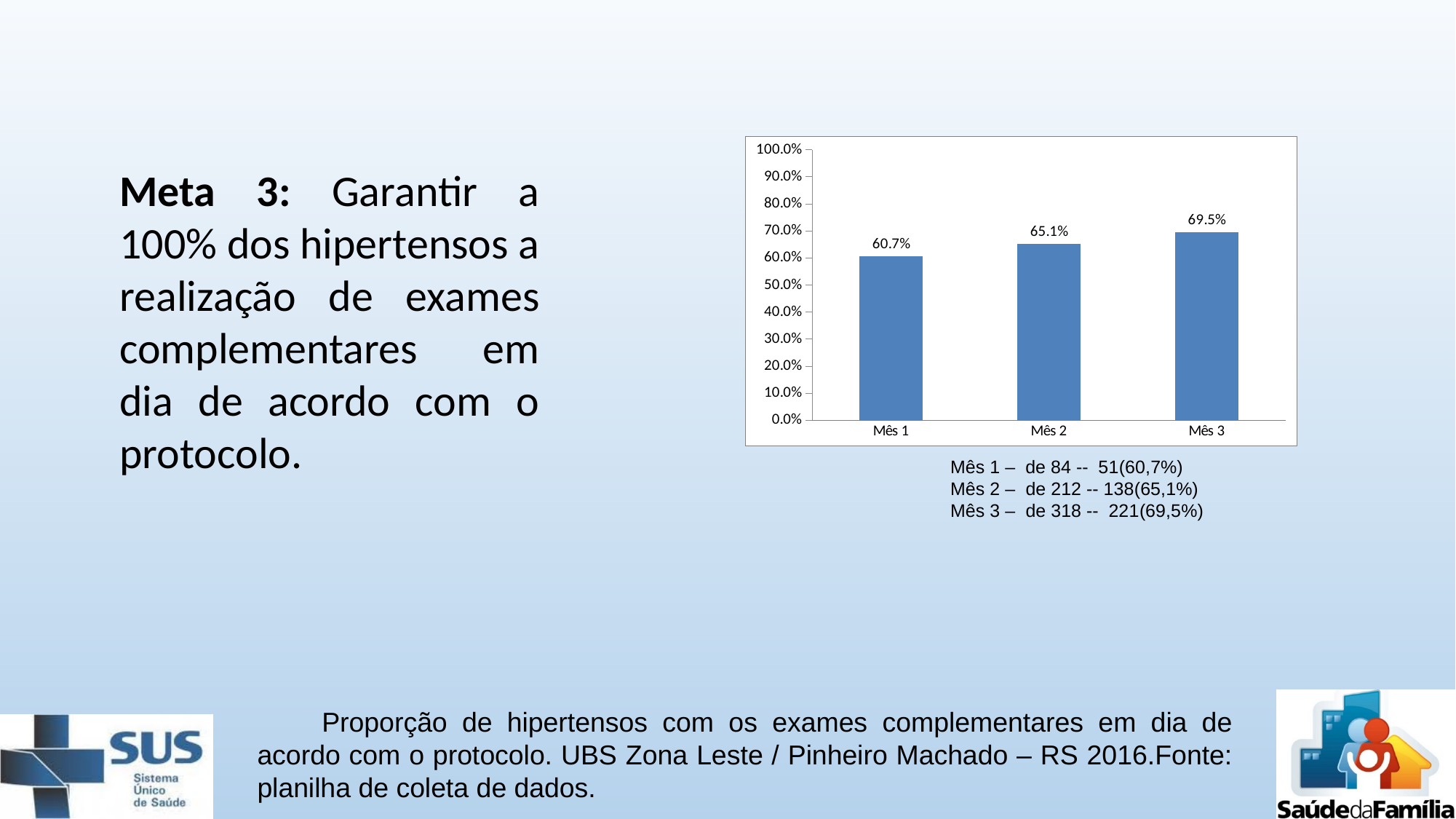
Is the value for Mês 1 greater or less than 70.0%? less What kind of chart is shown? bar chart Which is larger, the value for Mês 2 or the value for Mês 3? Mês 3 What is the value for Mês 1? 60.7% What is the value for Mês 2? 65.1% Which month has the highest value? Mês 3 Which month has the lowest value? Mês 1 What is the difference between the values for Mês 3 and Mês 1? 8.8% Do the values rise or fall from Mês 1 to Mês 3? rise What is the value for Mês 3? 69.5% How many categories are shown on the x axis? 3 What is the difference between the values for Mês 2 and Mês 1? 4.4%